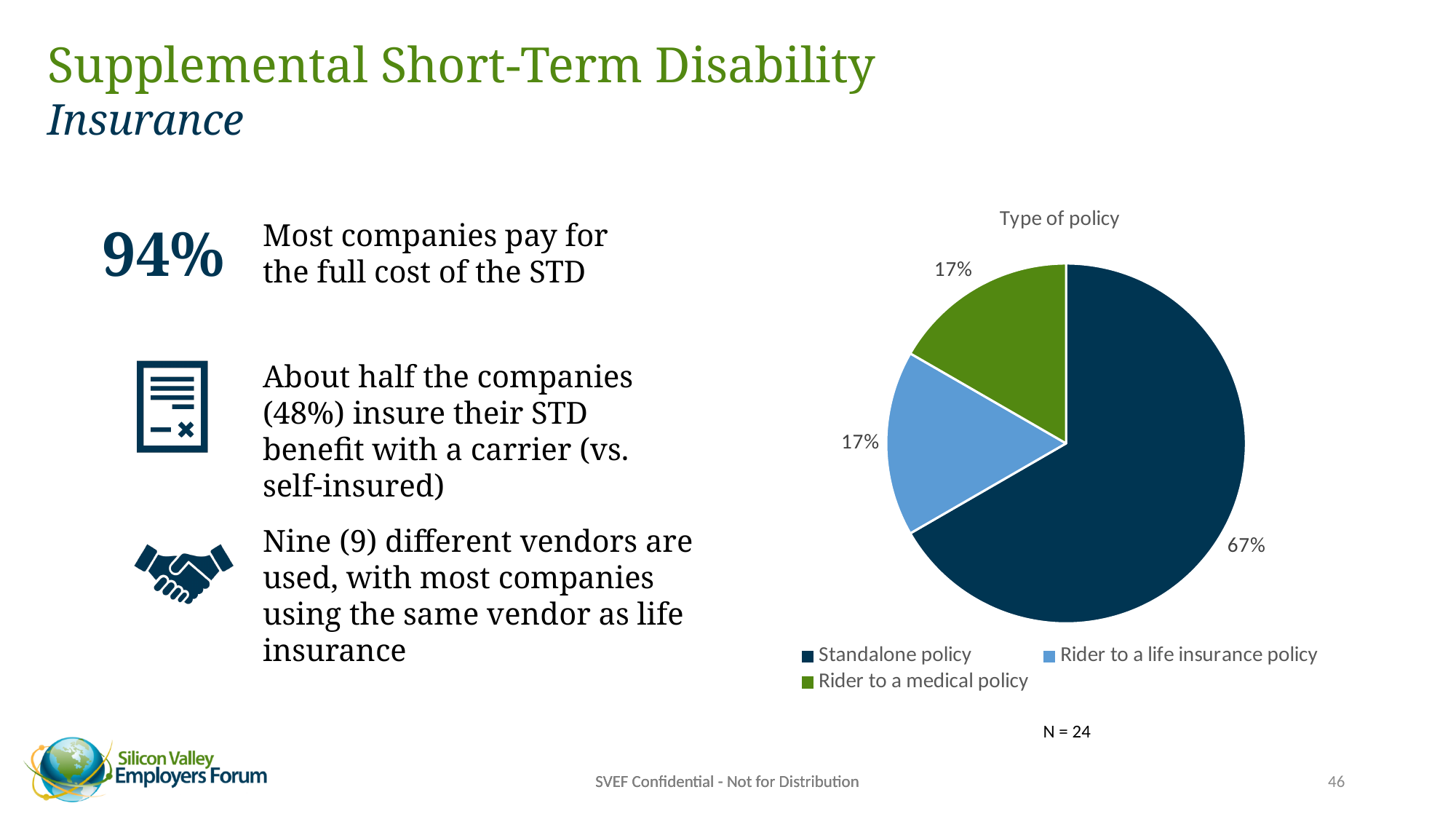
Which is larger, the share for Standalone policy or the share for Rider to a life insurance policy? Standalone policy How many slices does the pie chart have? 3 What share of the pie is Standalone policy? 67% What is the sample size (N) noted below the chart? N = 24 Which policy type has the largest slice of the pie? Standalone policy What is the title of the chart? Type of policy What share of the pie is Rider to a medical policy? 17% What is the difference in percentage points between Standalone policy and Rider to a medical policy? 50 What type of chart is shown on the slide? Pie chart What share of the pie is Rider to a life insurance policy? 17% How many entries does the legend list? 3